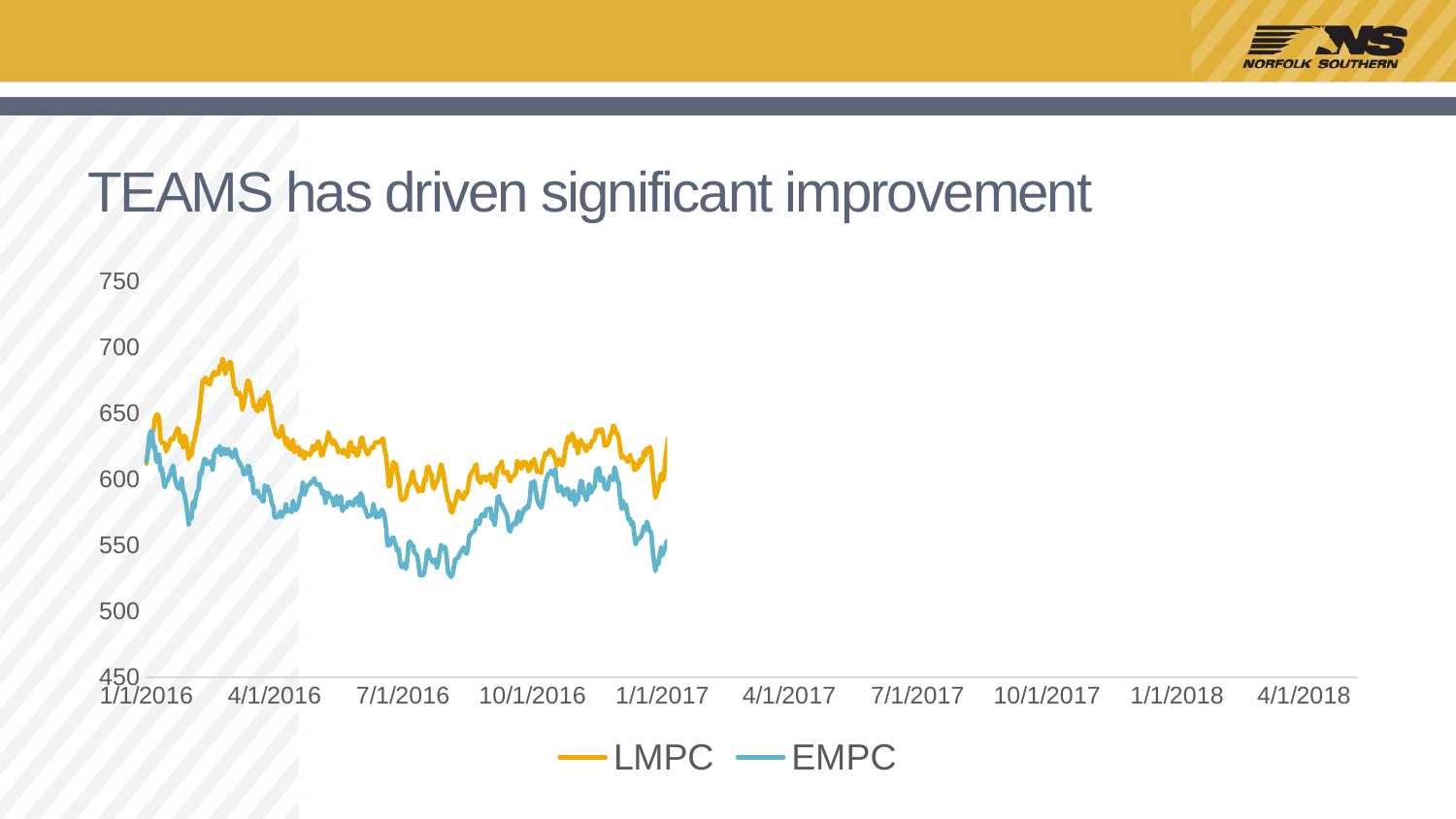
What is the lowest value shown on the vertical axis? 450 Is the highest value reached by LMPC greater or less than 650? greater Is the lowest value reached by EMPC greater or less than 550? less Which series generally has higher values, LMPC or EMPC? LMPC Which series is plotted in yellow? LMPC What are the two series named in the legend? LMPC and EMPC Is the lowest value reached by LMPC greater or less than 550? greater Does the LMPC line rise or fall between 4/1/2016 and 7/1/2016? fall What kind of chart is shown on the slide? line chart How many series does the legend list? 2